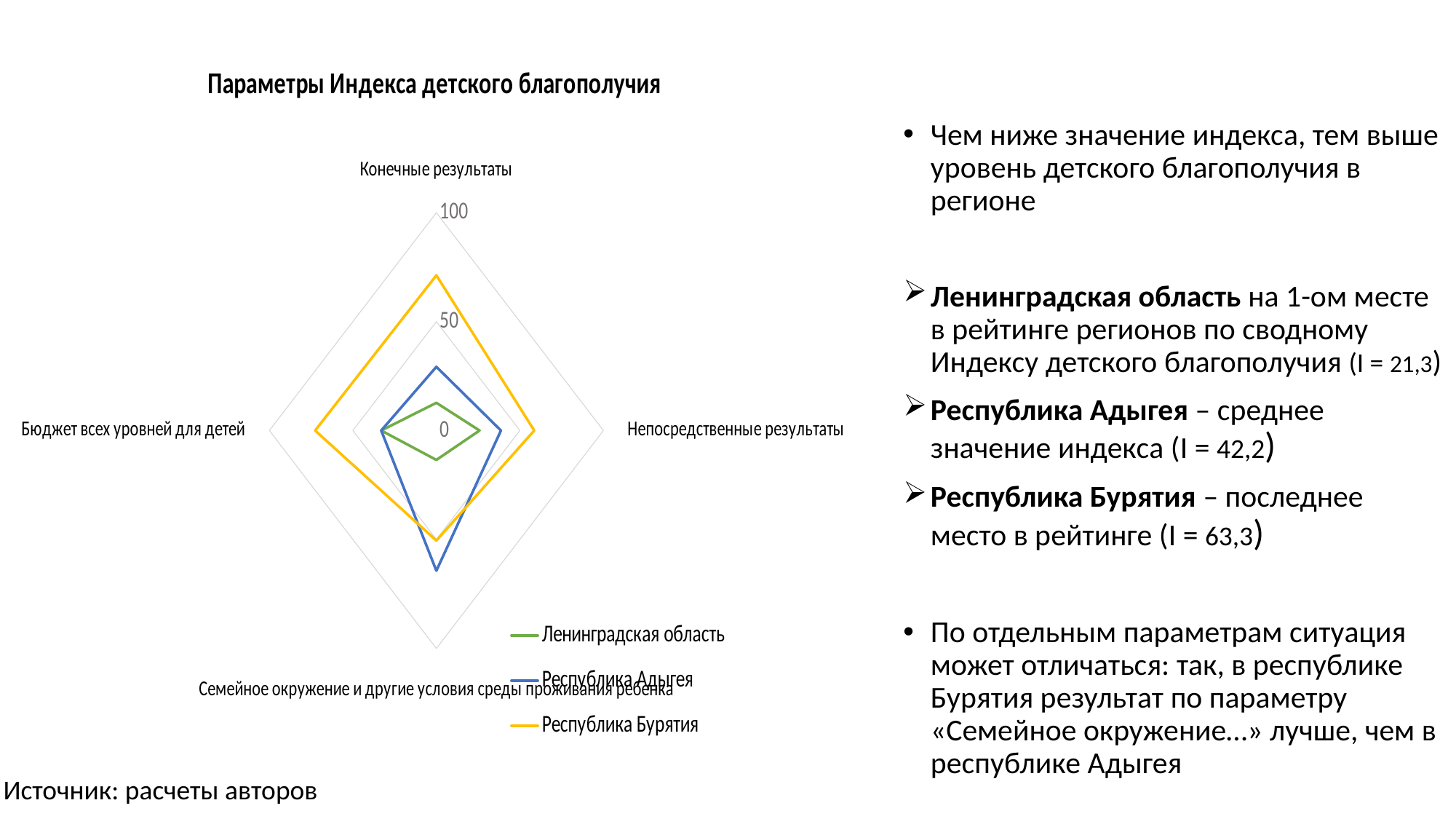
Is the value for Республика Адыгея on the Бюджет всех уровней для детей axis greater or less than 50? less Which region has the highest value on the Конечные результаты axis? Республика Бурятия Which region has the lowest value on the Семейное окружение и другие условия среды проживания ребенка axis? Ленинградская область Which series is drawn in yellow? Республика Бурятия How many parameters (axes) does the radar chart have? 4 What is the title of the chart? Параметры Индекса детского благополучия How many series does the chart legend list? 3 Is the value for Республика Бурятия on the Конечные результаты axis greater or less than 50? greater On the Семейное окружение и другие условия среды проживания ребенка axis, which is larger: the value for Республика Адыгея or for Республика Бурятия? Республика Адыгея Is the value for Ленинградская область on the Конечные результаты axis greater or less than 50? less What kind of chart is shown on the slide? Radar chart